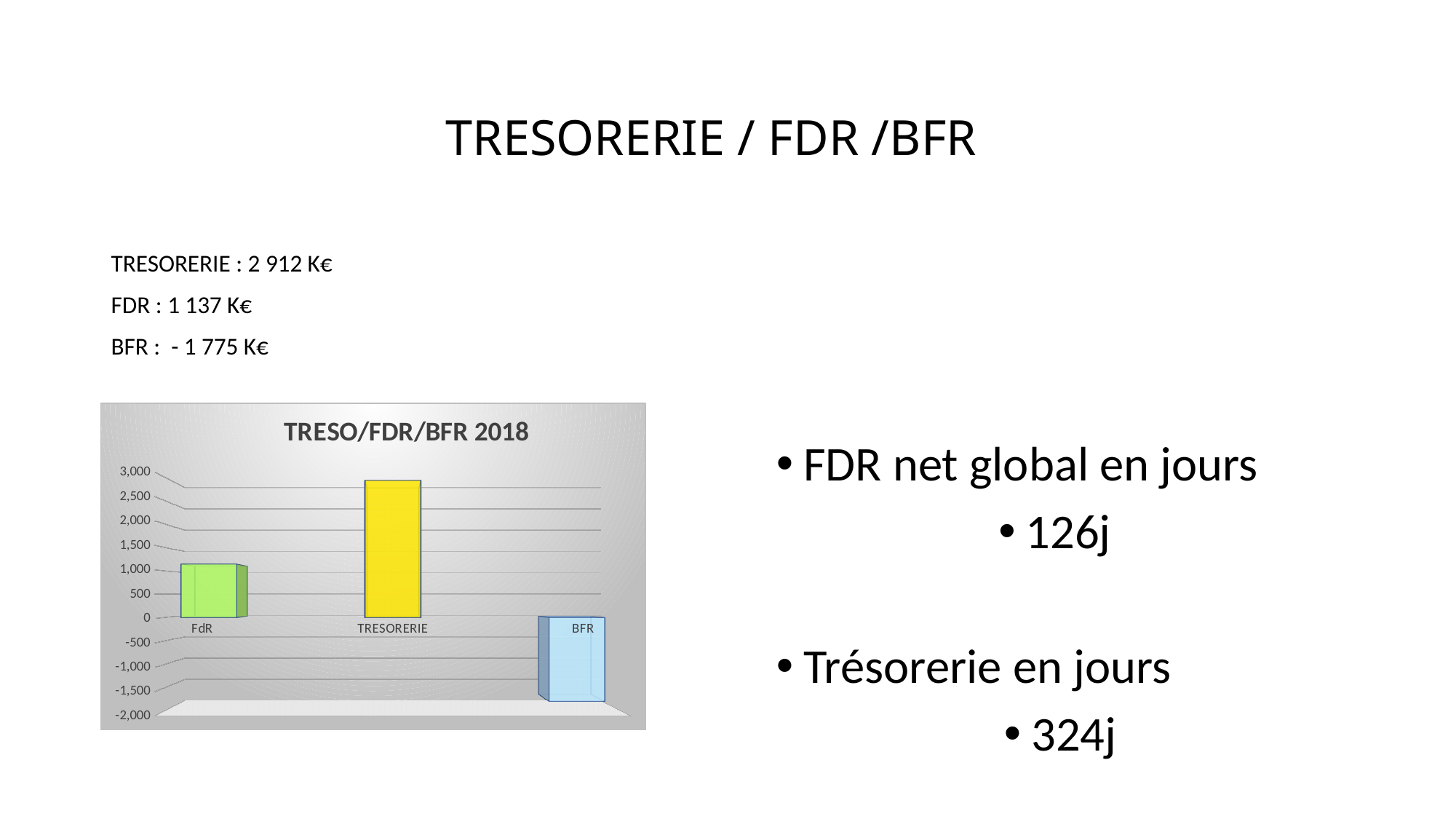
Which category has the lowest value in the chart? BFR According to the slide, what is the value of BFR? - 1 775 K€ Is the value for TRESORERIE greater or less than 2,500? greater What kind of chart is shown on the slide? bar chart According to the slide, what is the value of TRESORERIE? 2 912 K€ Which category has the highest value in the chart? TRESORERIE Is the value for FdR greater or less than 1,500? less Which is larger, the value for FdR or the value for TRESORERIE? TRESORERIE Is the value for BFR greater or less than -1,000? less What is the title of the chart? TRESO/FDR/BFR 2018 What colour is the TRESORERIE bar in the chart? yellow How many categories are plotted in the chart? 3